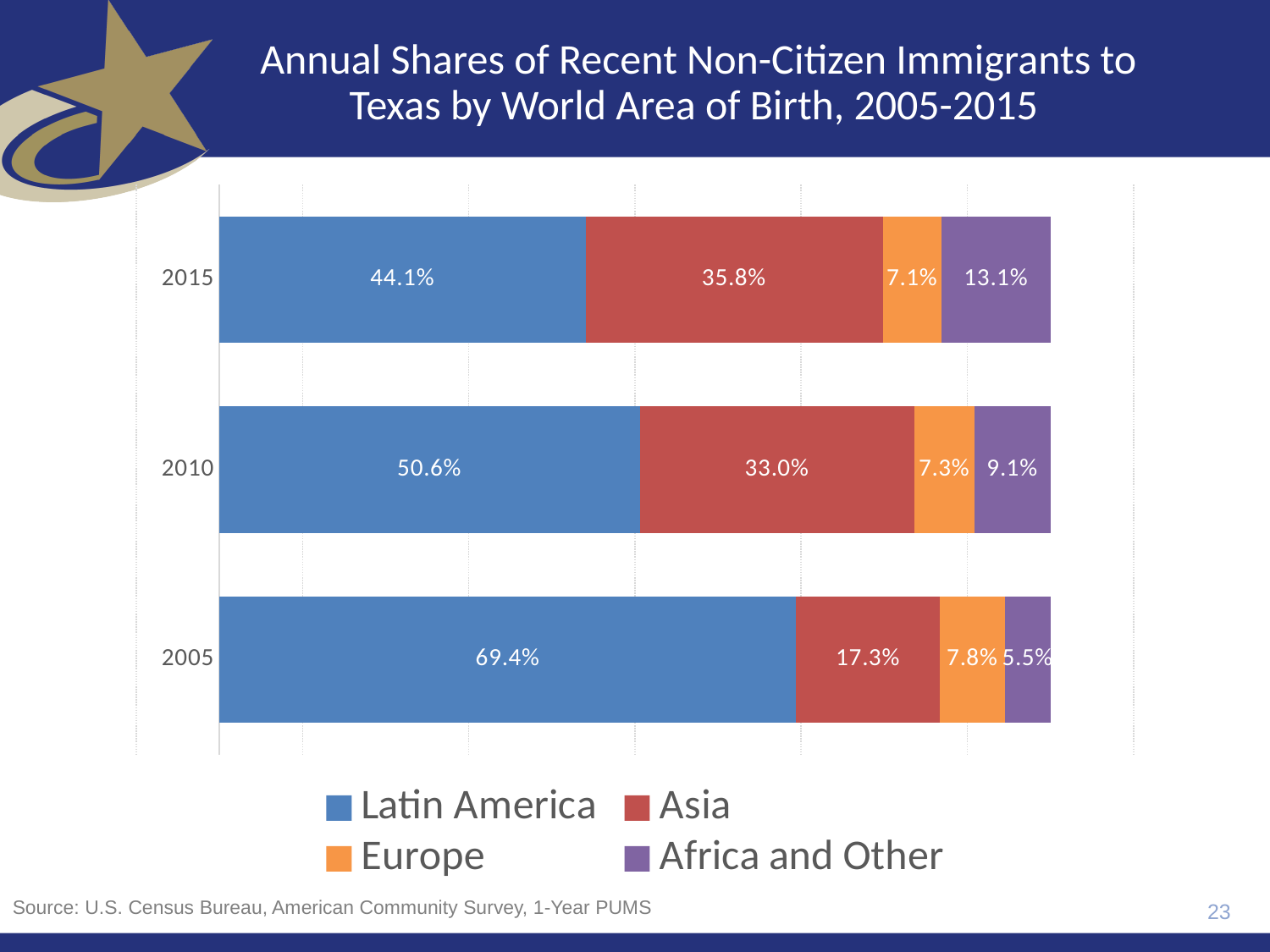
How many series does the legend list? 4 In which year was the Latin America share highest? 2005 What kind of chart is shown on the slide? Stacked bar chart By how many percentage points did the Latin America share fall from 2005 to 2015? 25.3 How many years are shown on the chart? 3 What is the Asia share for 2010? 33.0% What is the Europe share for 2005? 7.8% Which colour represents Asia in the chart? Red What is the Africa and Other share for 2015? 13.1% In which year was the Asia share lowest? 2005 Which is larger in 2010: the Europe share or the Africa and Other share? Africa and Other What share of recent non-citizen immigrants to Texas in 2015 were born in Latin America? 44.1%